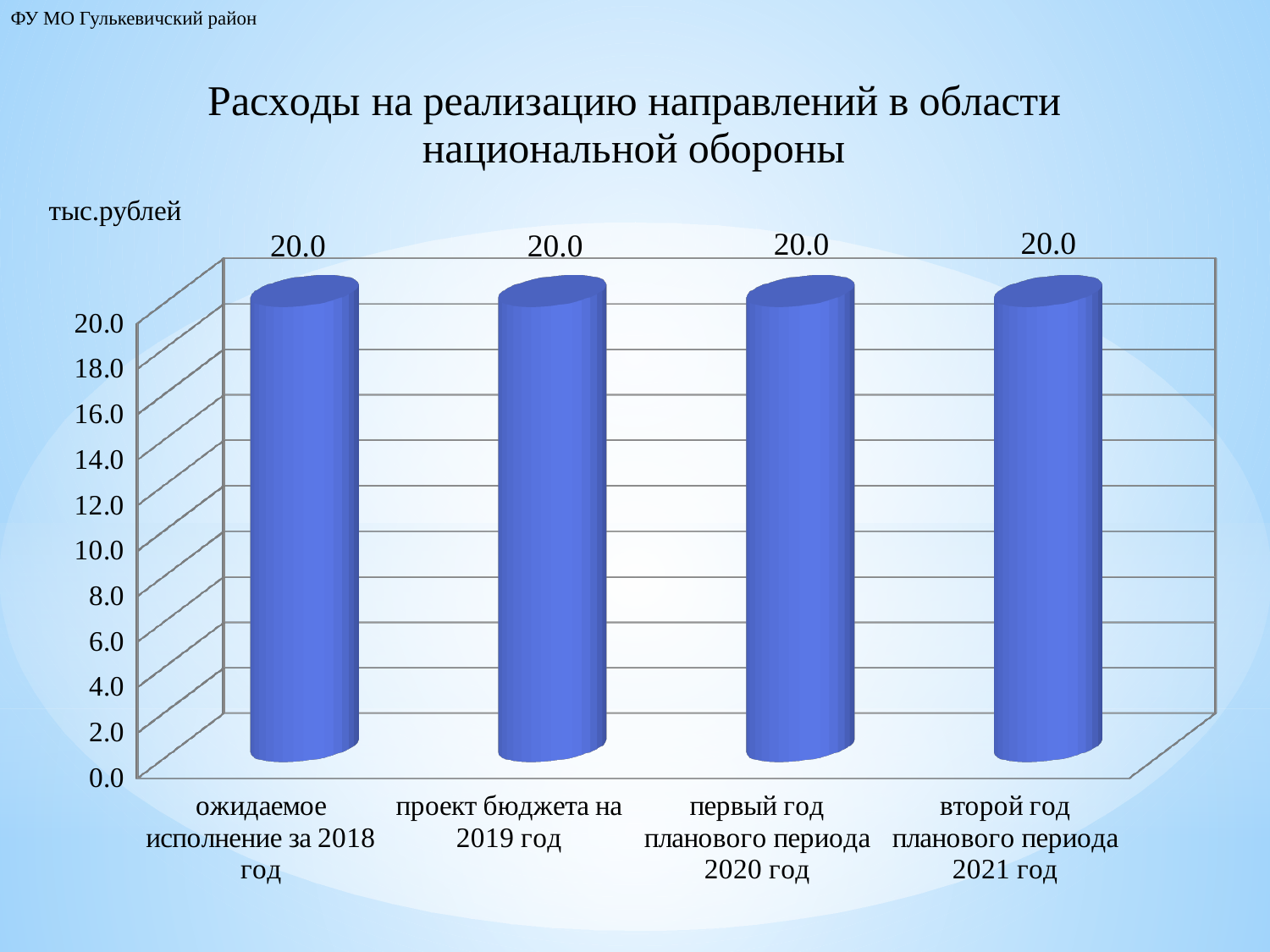
What unit of measurement is indicated for the chart values? тыс.рублей What is the value for 'первый год планового периода 2020 год'? 20.0 What is the title of the chart? Расходы на реализацию направлений в области национальной обороны How many categories are shown on the x axis? 4 Is the value for 'проект бюджета на 2019 год' greater or less than 10.0? greater What is the value for 'ожидаемое исполнение за 2018 год'? 20.0 What is the value for 'второй год планового периода 2021 год'? 20.0 What is the difference between the value for 2021 and the value for 2018? 0.0 What is the value for 'проект бюджета на 2019 год'? 20.0 Do the values rise, fall, or stay the same from 2018 to 2021? stay the same What kind of chart is shown on the slide? bar chart